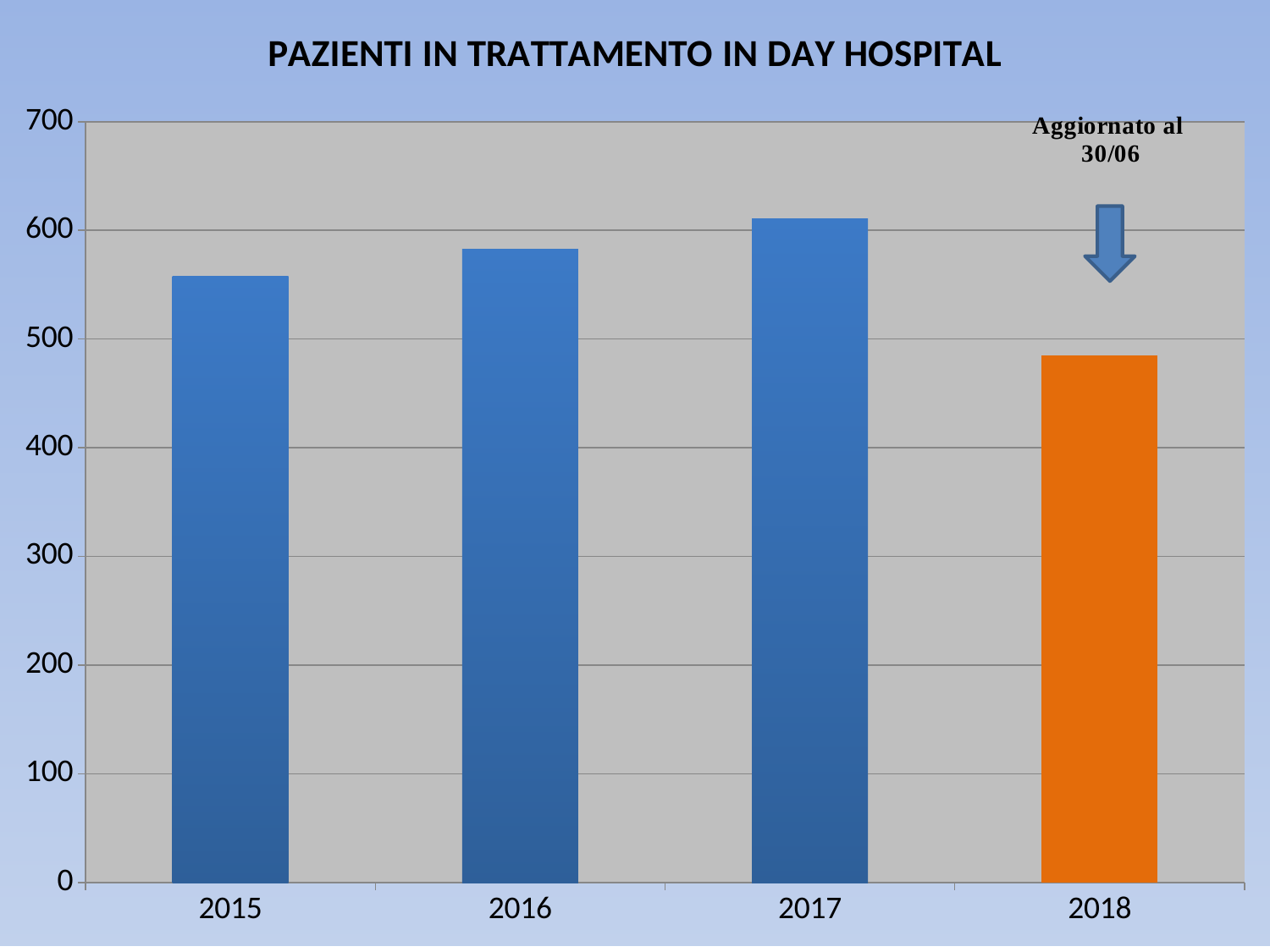
Is the value for 2015 greater or less than 500? greater Which bar is coloured orange instead of blue? 2018 Is the value for 2016 greater or less than 600? less How many years are shown on the x axis of the chart? 4 Which year has the lowest number of patients in day hospital treatment? 2018 What kind of chart is shown on the slide? bar chart Do the values rise or fall from 2015 to 2017? rise Which year has the larger value, 2015 or 2017? 2017 Which year has the highest number of patients in day hospital treatment? 2017 Is the value for 2017 greater or less than 600? greater What is the title of the chart? PAZIENTI IN TRATTAMENTO IN DAY HOSPITAL